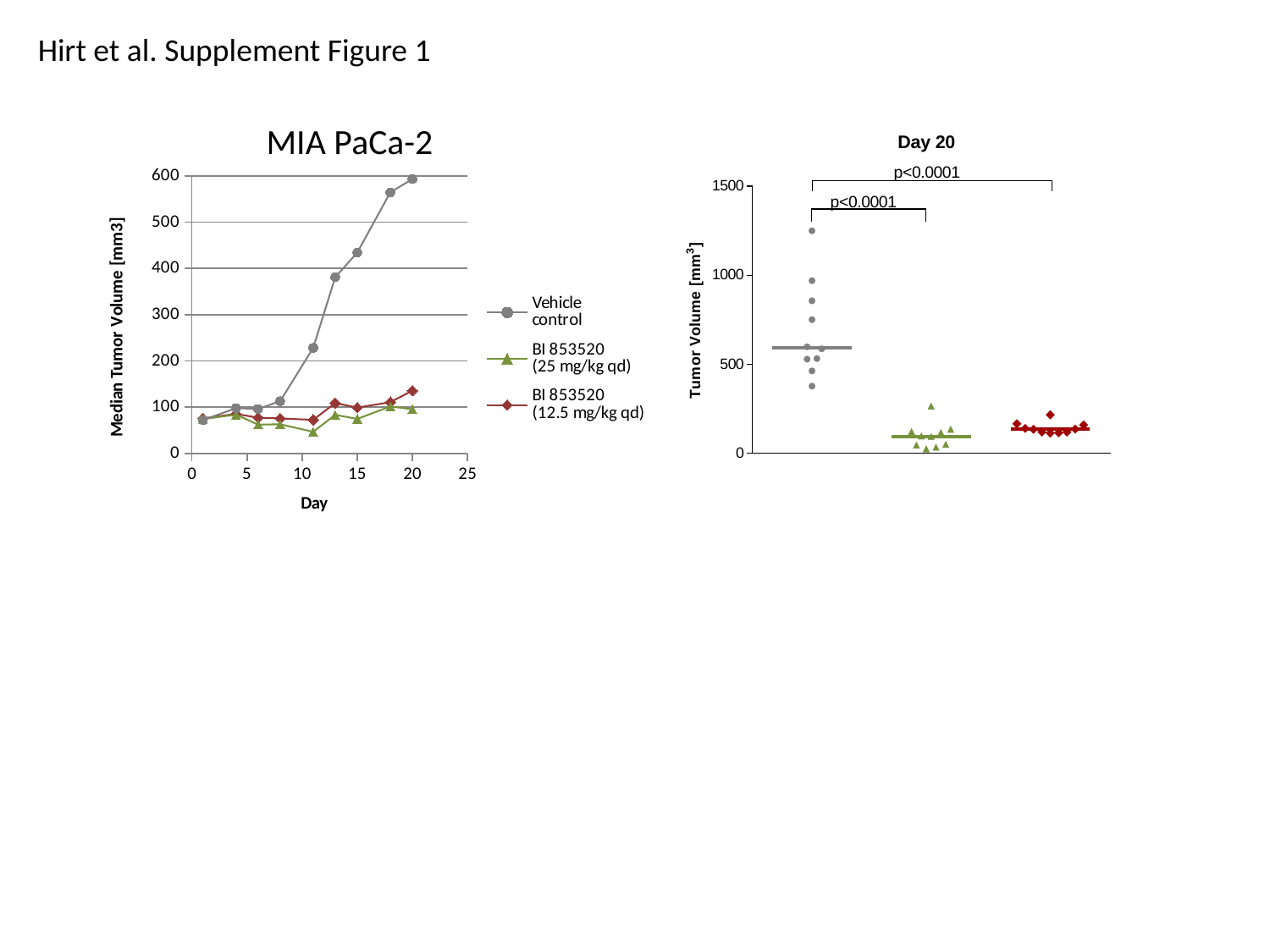
In the MIA PaCa-2 chart, which series has the lowest value at day 11? BI 853520 (25 mg/kg qd) In the MIA PaCa-2 chart, is the Vehicle control value at day 13 greater or less than 400? less What is the title of the chart on the left of the slide? MIA PaCa-2 In the MIA PaCa-2 chart, is the Vehicle control value at day 20 greater or less than 500? greater What is the title of the chart on the right of the slide? Day 20 In the MIA PaCa-2 chart, which series has the highest value at day 20? Vehicle control In the Day 20 chart, is the highest grey Vehicle control point greater or less than 1000? greater In the MIA PaCa-2 chart, at day 20, which is larger: Vehicle control or BI 853520 (12.5 mg/kg qd)? Vehicle control In the MIA PaCa-2 chart, what kind of chart is shown? line chart In the MIA PaCa-2 chart, does the Vehicle control series rise or fall as the day increases? rise In the MIA PaCa-2 chart, how many series does the legend list? 3